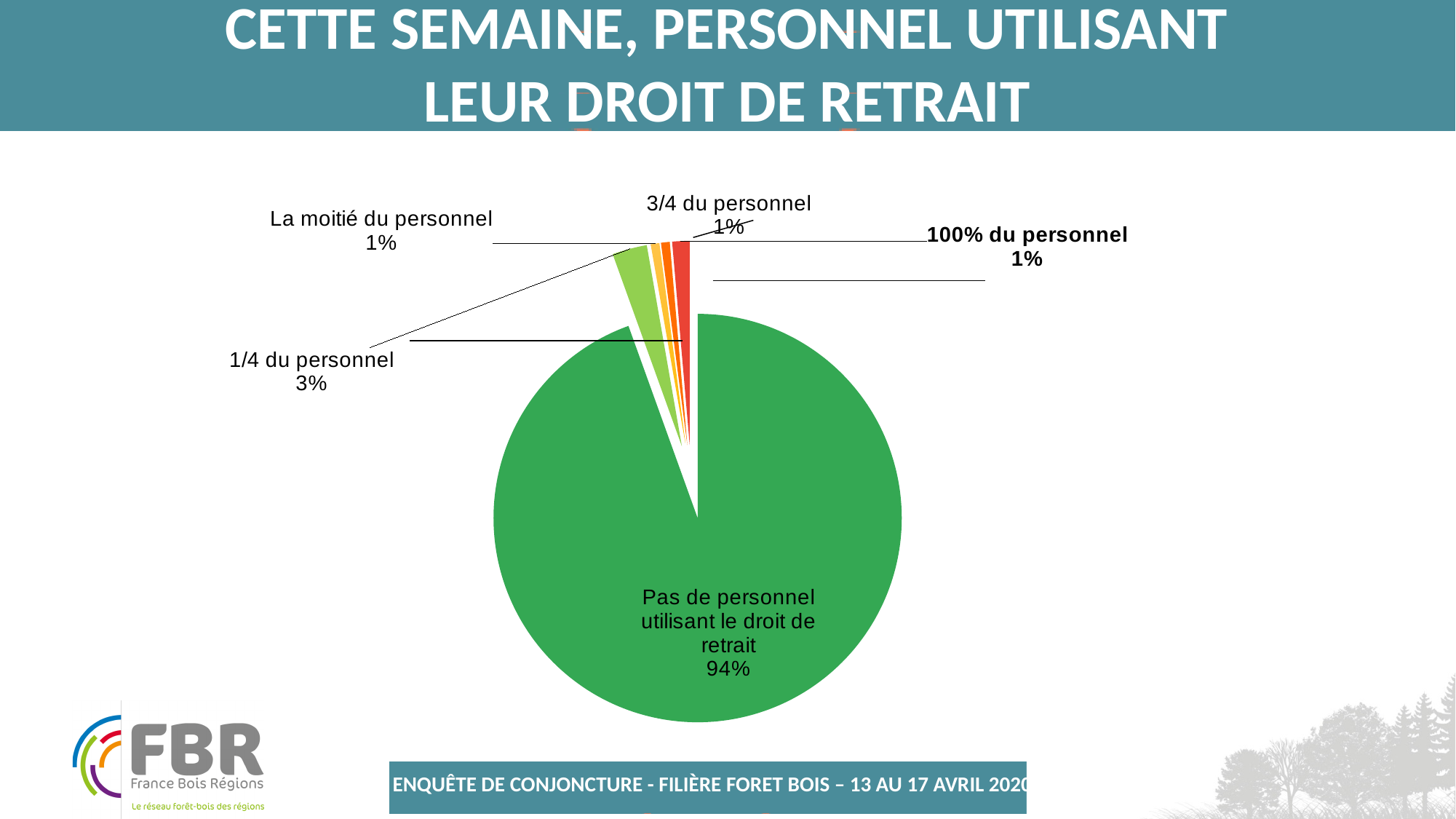
How many slices does the pie chart have? 5 What is the value shown for "3/4 du personnel"? 1% What is the value shown for "La moitié du personnel"? 1% What share of the pie is labelled "Pas de personnel utilisant le droit de retrait"? 94% What kind of chart is shown on the slide? pie chart What is the value shown for "1/4 du personnel"? 3% What is the difference between the share for "Pas de personnel utilisant le droit de retrait" and the share for "1/4 du personnel"? 91% Which category has the largest slice of the pie? Pas de personnel utilisant le droit de retrait What colour is the largest slice of the pie chart? green Which is larger, the share for "1/4 du personnel" or the share for "La moitié du personnel"? 1/4 du personnel What is the title of the slide containing the pie chart? CETTE SEMAINE, PERSONNEL UTILISANT LEUR DROIT DE RETRAIT What is the value shown for "100% du personnel"? 1%